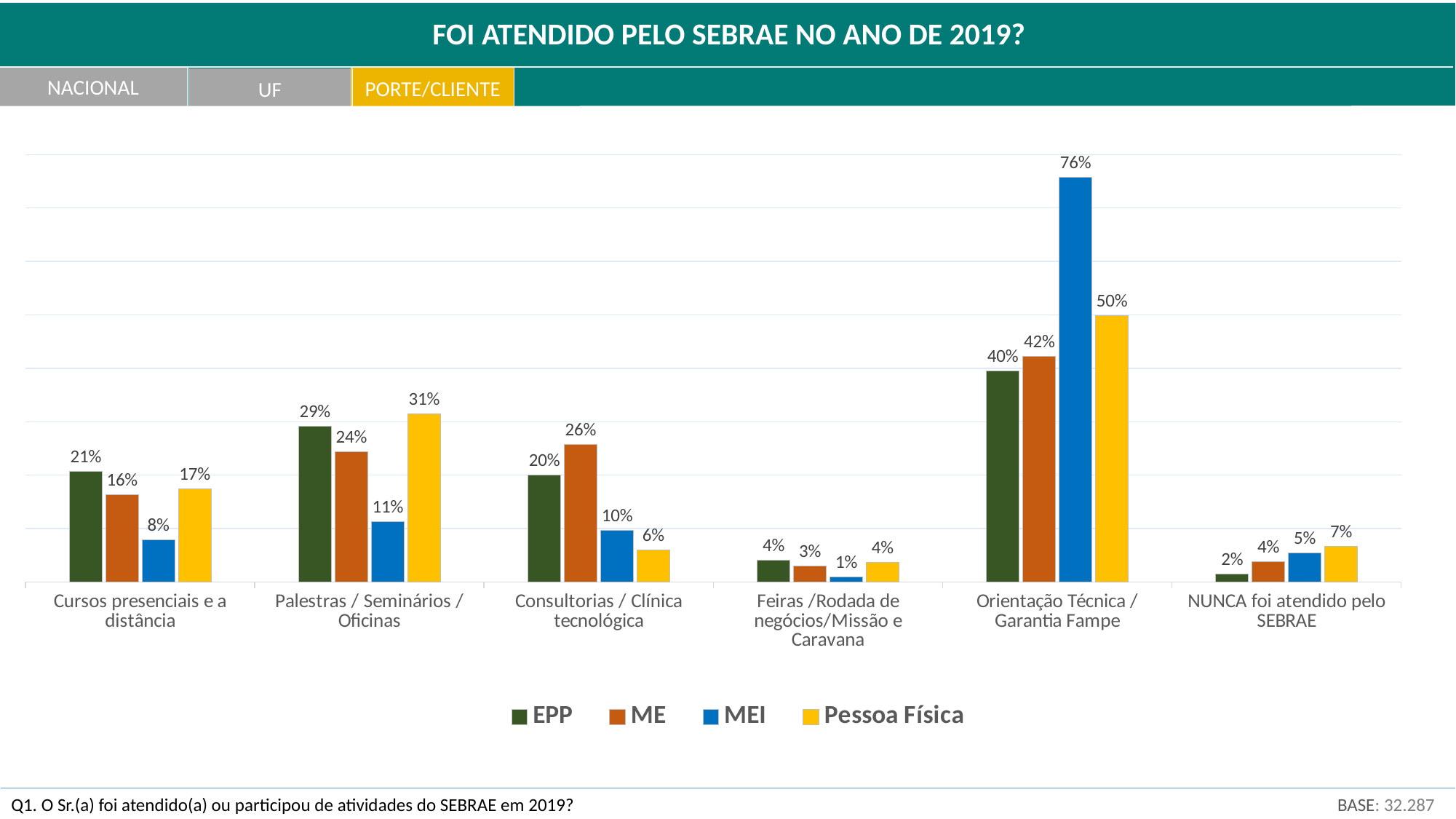
What is the value for MEI in the 'Orientação Técnica / Garantia Fampe' category? 76% How many series does the legend list? 4 How many categories are shown on the x axis? 6 What is the value for EPP in the 'Cursos presenciais e a distância' category? 21% Which series has the lowest value in the 'Feiras /Rodada de negócios/Missão e Caravana' category? MEI What kind of chart is shown on the slide? Bar chart Which series has the highest value in the 'Orientação Técnica / Garantia Fampe' category? MEI What is the difference between the MEI and Pessoa Física values in the 'Orientação Técnica / Garantia Fampe' category? 26% Which is larger in the 'Consultorias / Clínica tecnológica' category: the EPP value or the ME value? ME What is the value for ME in the 'Consultorias / Clínica tecnológica' category? 26% What is the title of the chart? FOI ATENDIDO PELO SEBRAE NO ANO DE 2019? What is the value for Pessoa Física in the 'Palestras / Seminários / Oficinas' category? 31%